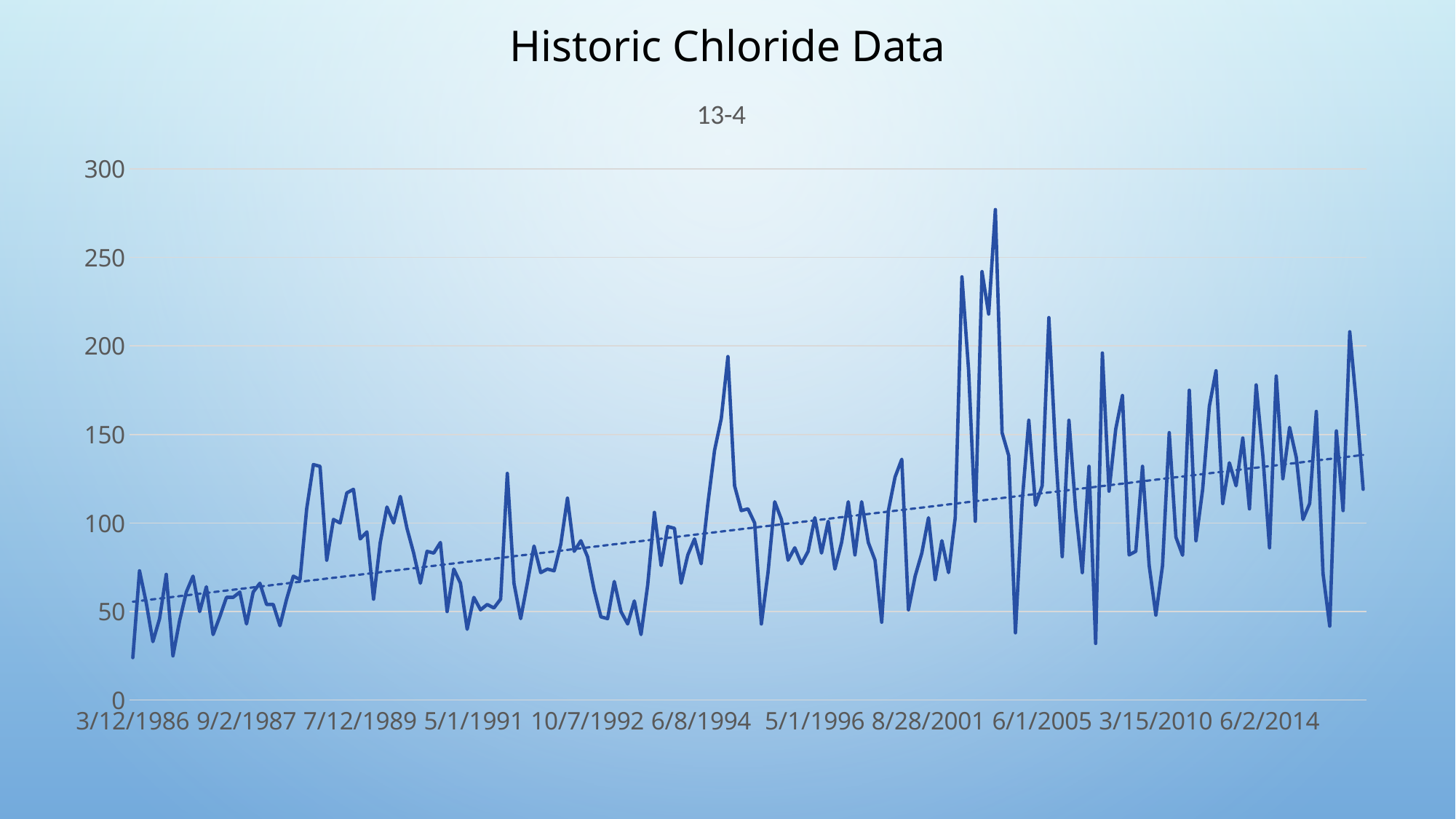
Do the chloride values generally rise or fall along the x axis, as shown by the dotted trend line? rise Is the value at the first point (3/12/1986) greater or less than 50? less Is the highest value plotted on the chart greater or less than 250? greater What is the highest value labelled on the y axis? 300 What kind of chart is shown on the slide? line chart Is the value at the point where the trend line ends (right side) greater or less than 100? greater How many date labels are shown on the x axis? 11 What is the title of the chart? 13-4